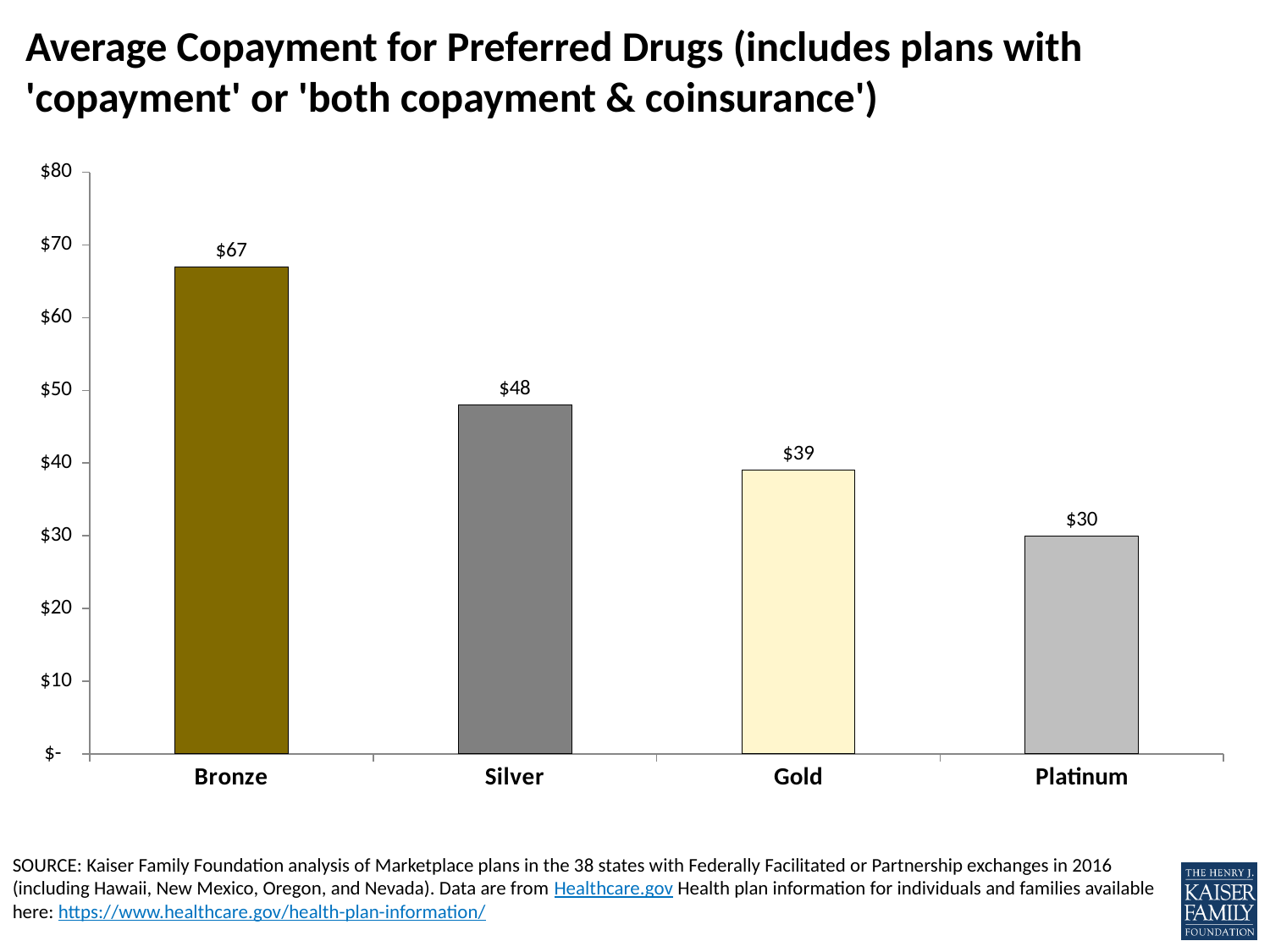
Which plan type has the highest average copayment for preferred drugs? Bronze Which has a higher average copayment for preferred drugs, Silver or Gold? Silver What is the average copayment for preferred drugs for Bronze plans? $67 What is the average copayment for preferred drugs for Platinum plans? $30 Which plan type has the lowest average copayment for preferred drugs? Platinum How many plan types are shown in the chart? 4 What is the difference between the average copayment for Silver plans and Gold plans? $9 What is the average copayment for preferred drugs for Silver plans? $48 Do the average copayment values rise or fall moving from Bronze to Platinum along the x axis? Fall What kind of chart is shown on the slide? Bar chart What is the average copayment for preferred drugs for Gold plans? $39 What is the difference between the average copayment for Bronze plans and Platinum plans? $37